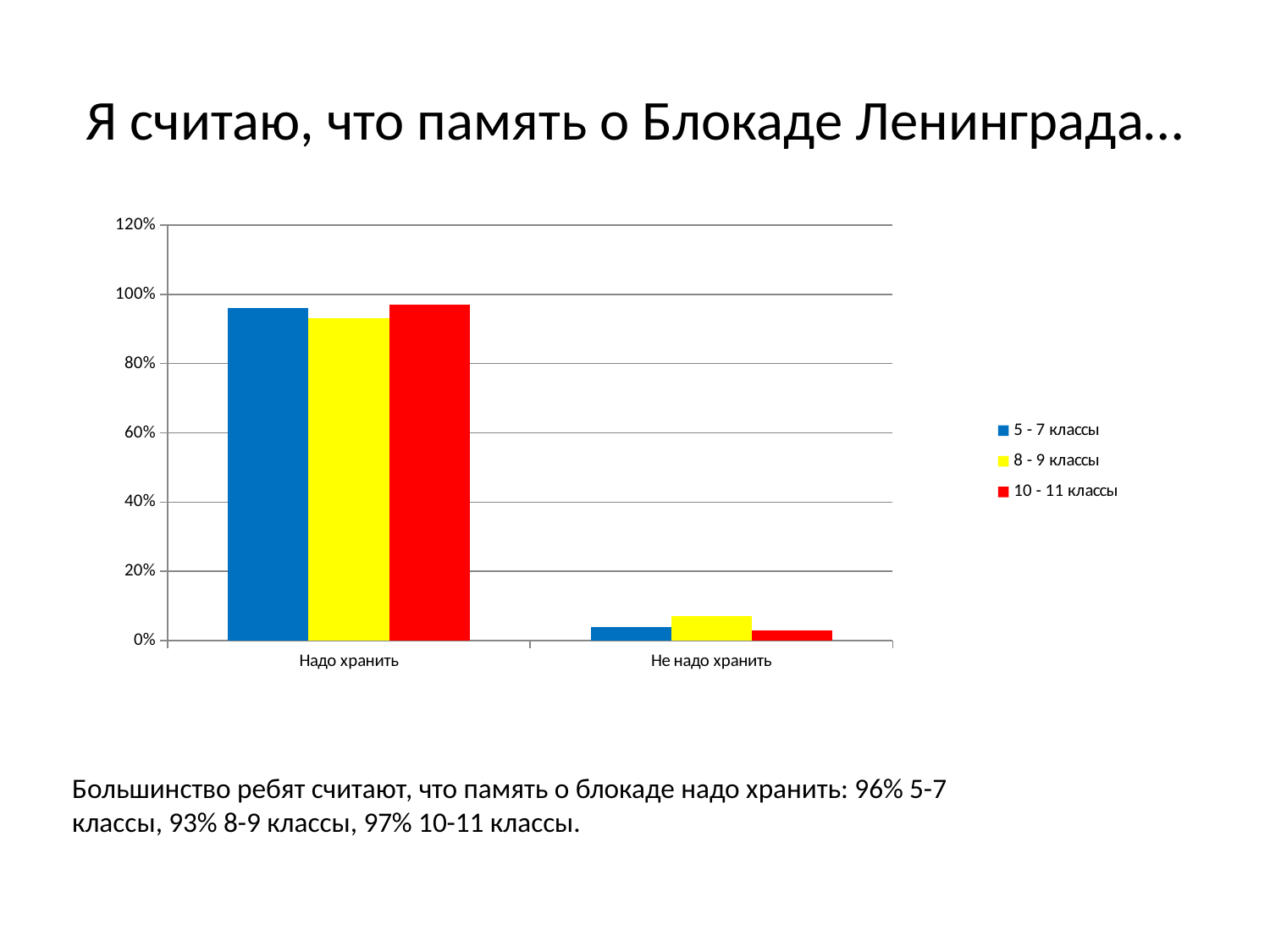
Is the value for 8 - 9 классы in the category Не надо хранить greater or less than 20%? less Which series has the highest value in the category Надо хранить? 10 - 11 классы How many series does the legend list? 3 What kind of chart is shown on the slide? bar chart Which series has the lowest value in the category Надо хранить? 8 - 9 классы What colour represents the series 10 - 11 классы in the legend? red What is the value for 10 - 11 классы in the category Надо хранить? 97% What is the difference between the values for 10 - 11 классы and 8 - 9 классы in the category Надо хранить? 4% What is the value for 8 - 9 классы in the category Надо хранить? 93% How many categories are shown on the x axis? 2 Which is larger: the value for 5 - 7 классы in Надо хранить or in Не надо хранить? Надо хранить What is the value for 5 - 7 классы in the category Надо хранить? 96%